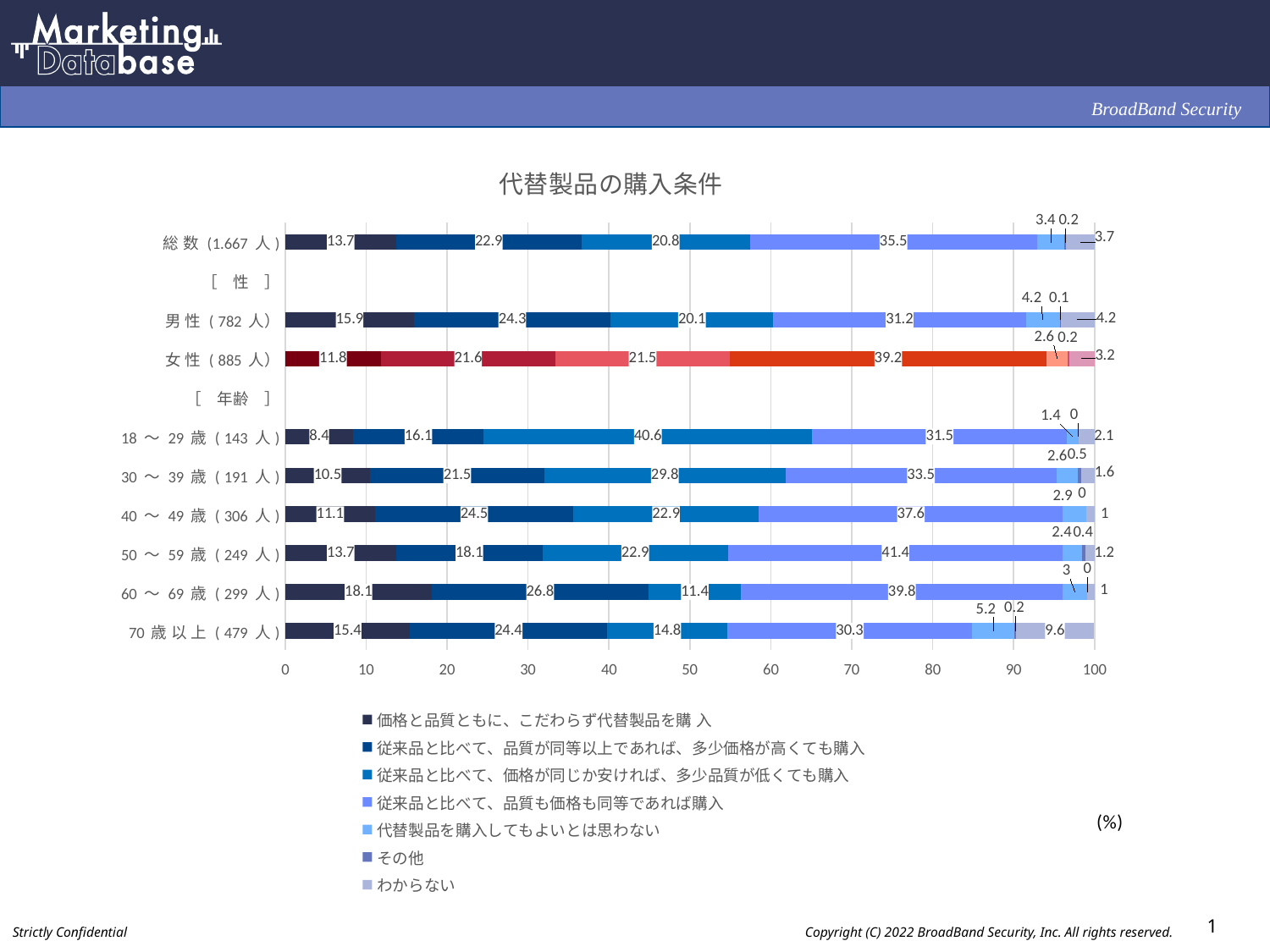
What is the value of 「従来品と比べて、品質も価格も同等であれば購入」 for 総数 (1,667人)? 35.5 Which age group has the lowest value for 「価格と品質ともに、こだわらず代替製品を購入」? 18～29歳 (143人) What is the value of 「価格と品質ともに、こだわらず代替製品を購入」 for 男性 (782人)? 15.9 What is the value of 「従来品と比べて、価格が同じか安ければ、多少品質が低くても購入」 for 18～29歳 (143人)? 40.6 What is the value of 「わからない」 for 70歳以上 (479人)? 9.6 What is the title of the chart? 代替製品の購入条件 Which is larger for 「従来品と比べて、価格が同じか安ければ、多少品質が低くても購入」: 60～69歳 (299人) or 70歳以上 (479人)? 70歳以上 (479人) What type of chart is shown on the slide? Stacked bar chart How many series does the legend list? 7 What is the difference between 男性 and 女性 for 「従来品と比べて、品質も価格も同等であれば購入」? 8 Which age group has the highest value for 「従来品と比べて、品質も価格も同等であれば購入」? 50～59歳 (249人) What is the value of 「代替製品を購入してもよいとは思わない」 for 女性 (885人)? 2.6